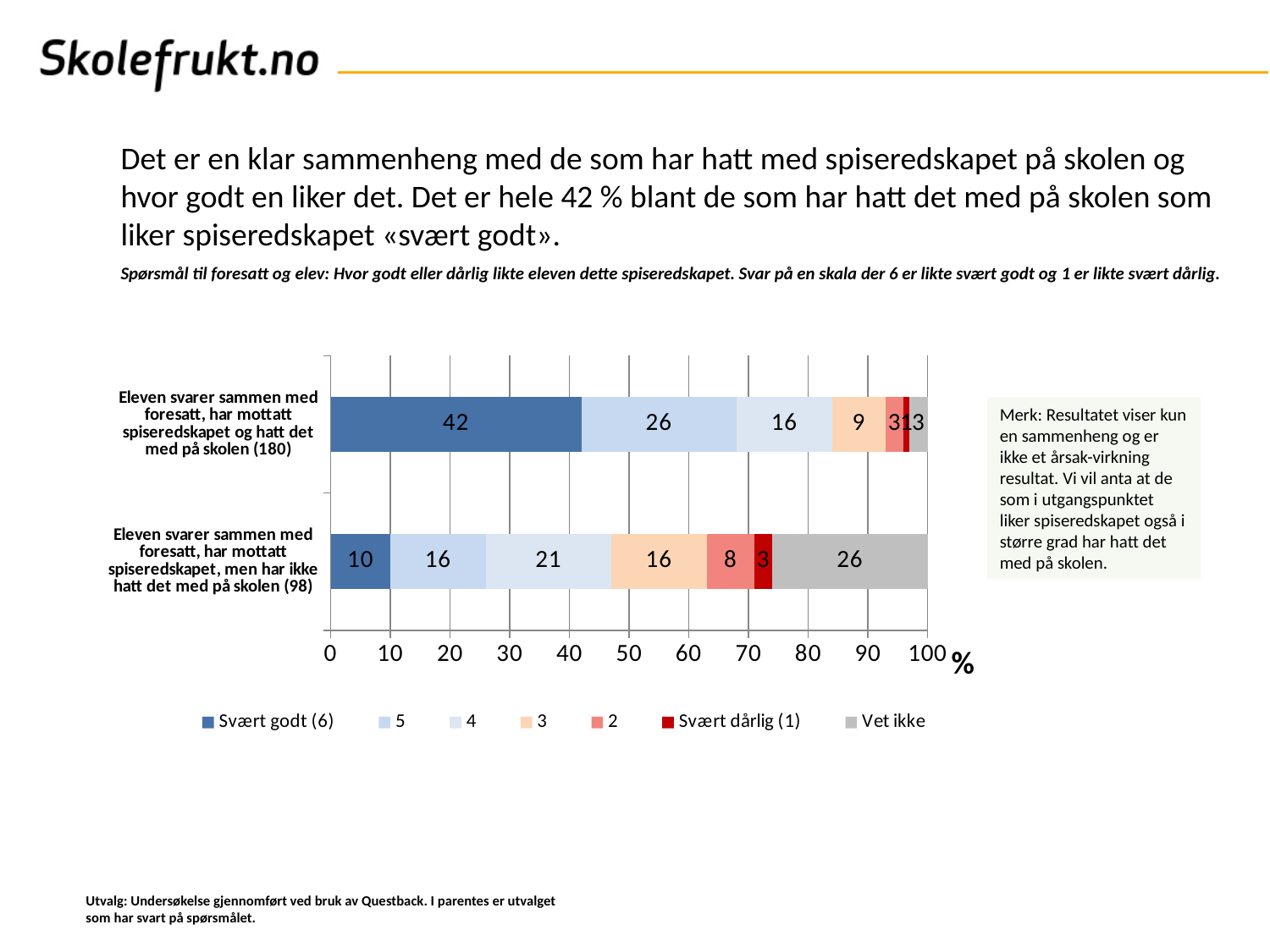
What is the difference in the 'Svært godt (6)' value between the group that had the utensil at school (42) and the group that did not (10)? 32 What is the value for 'Svært godt (6)' among those who have had the eating utensil with them at school (180)? 42 What is the value for 'Svært godt (6)' among those who have not had the eating utensil with them at school (98)? 10 What unit is shown at the end of the x axis? % What is the value for '3' among those who have had the eating utensil with them at school (180)? 9 Which group has the larger 'Svært godt (6)' share: those who have had the utensil with them at school or those who have not? Those who have had it with them at school (180) How many series does the legend list? 7 What kind of chart is shown on the slide? Stacked bar chart Which response has the largest share among those who have not had the eating utensil with them at school (98)? Vet ikke What is the value for 'Vet ikke' among those who have not had the eating utensil with them at school (98)? 26 How many categories (bars) does the chart show? 2 What is the value for '4' among those who have not had the eating utensil with them at school (98)? 21